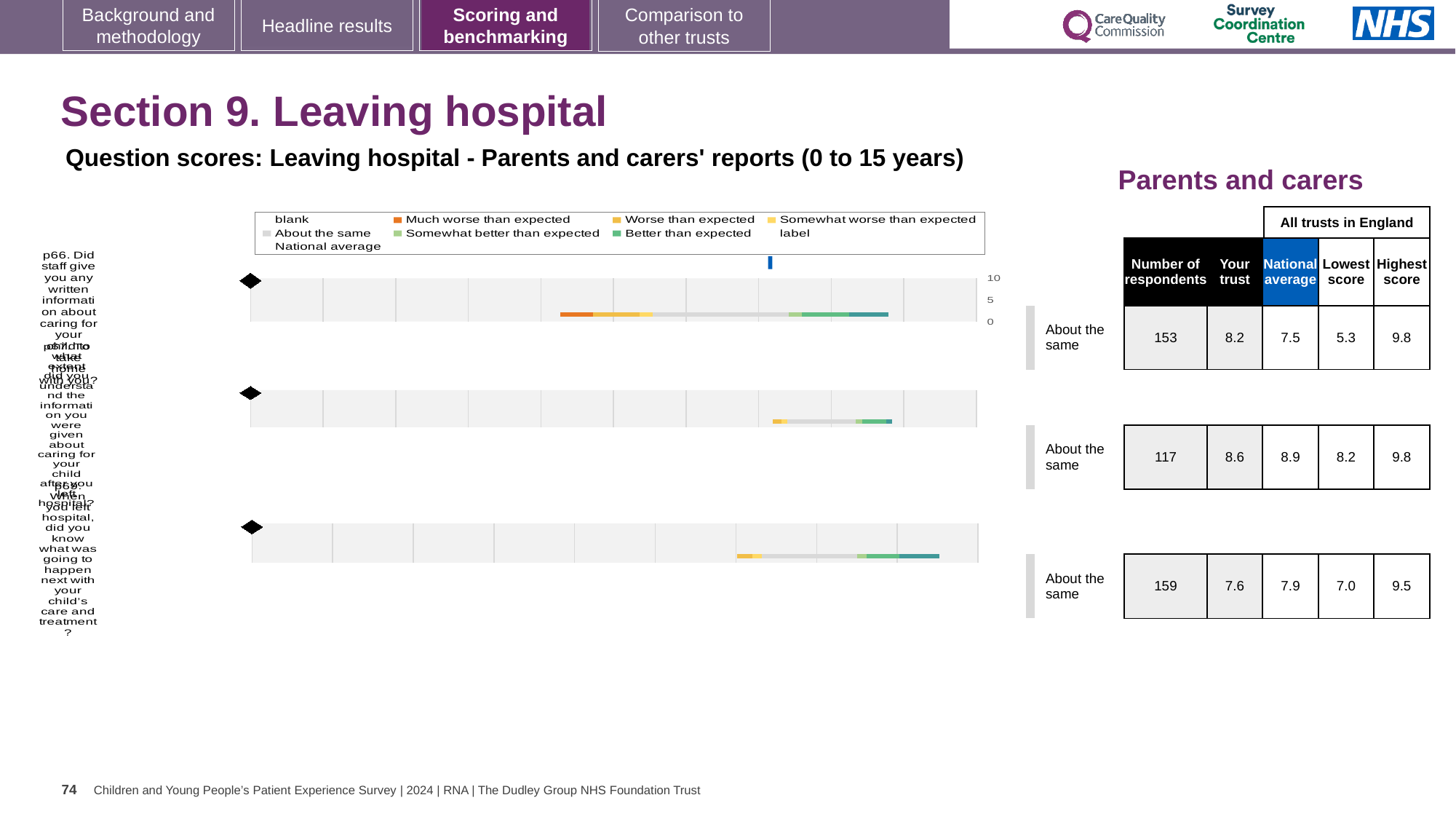
For the top chart (p66), what is the national average score? 7.5 How many question score charts (rows) are shown on the slide? 3 For the bottom chart (p68), what is the difference between the highest score and the lowest score among all trusts in England? 2.5 For the middle chart (p67), which is larger: the 'Your trust' score or the national average? National average For the top chart (p66), which is larger: the 'Your trust' score or the national average? Your trust What benchmark category is shown next to each of the three charts? About the same For the top chart (p66, written information about caring for your child at home), what is the 'Your trust' score shown in the table? 8.2 Which of the three charts has the highest number of respondents? The bottom chart (p68), with 159 For the middle chart (p67), how many respondents are listed? 117 What kind of chart is used to show the question scores on this slide? bar chart For the top chart (p66), what is the difference between the 'Your trust' score and the national average? 0.7 For the bottom chart (p68, did you know what was going to happen next), what is the highest score among all trusts in England? 9.5